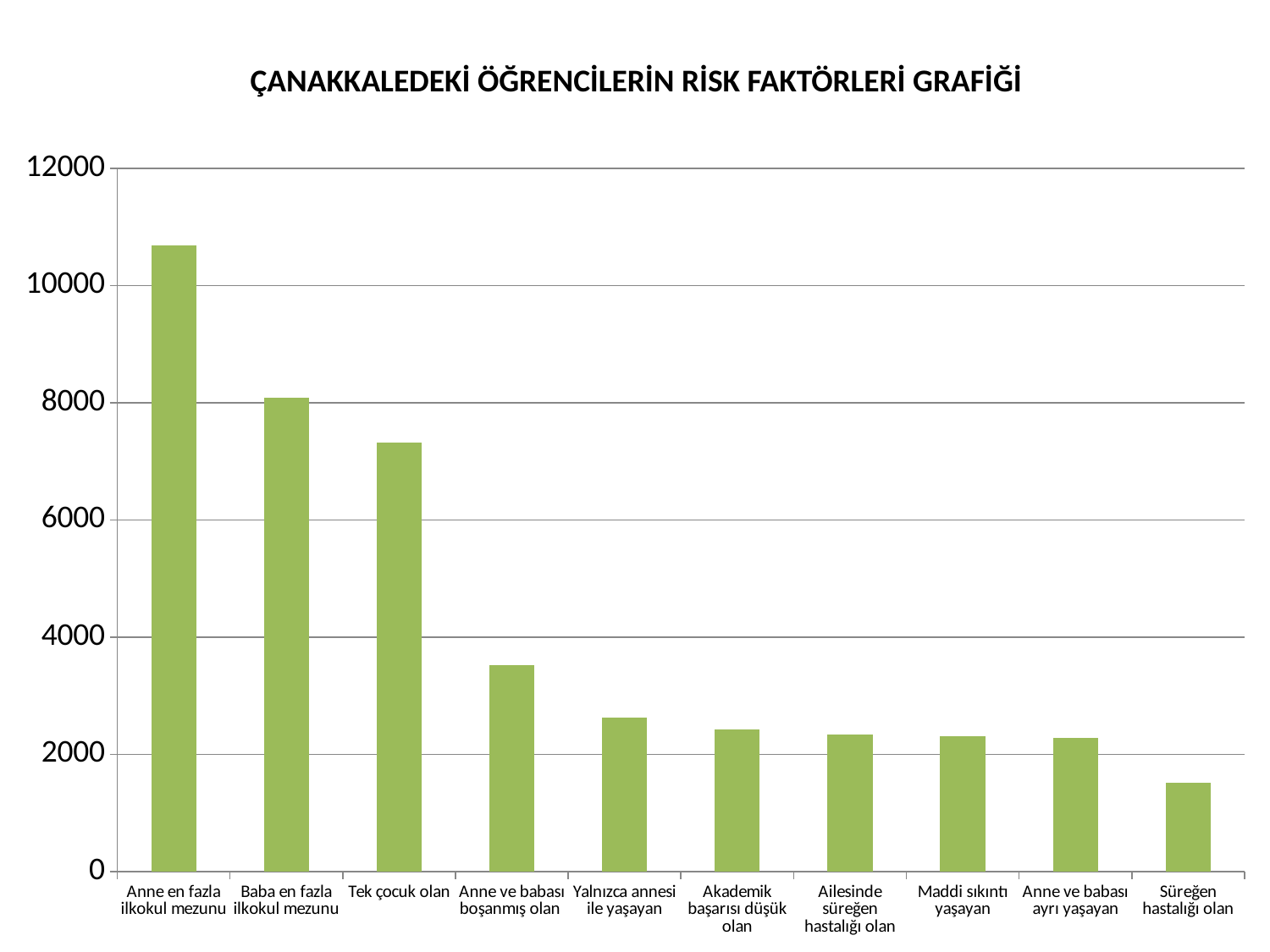
Which category has the lowest value? Süreğen hastalığı olan Is the value for Anne ve babası boşanmış olan greater or less than 4000? less Is the value for Anne en fazla ilkokul mezunu greater or less than 10000? greater What kind of chart is shown on the slide? bar chart Which is larger, the value for Baba en fazla ilkokul mezunu or the value for Tek çocuk olan? Baba en fazla ilkokul mezunu Is the value for Süreğen hastalığı olan greater or less than 2000? less Do the values rise or fall from left to right along the x axis? fall How many categories are plotted on the chart? 10 Which category has the highest value? Anne en fazla ilkokul mezunu What is the title of the chart? ÇANAKKALEDEKİ ÖĞRENCİLERİN RİSK FAKTÖRLERİ GRAFİĞİ What colour are the bars in the chart? green